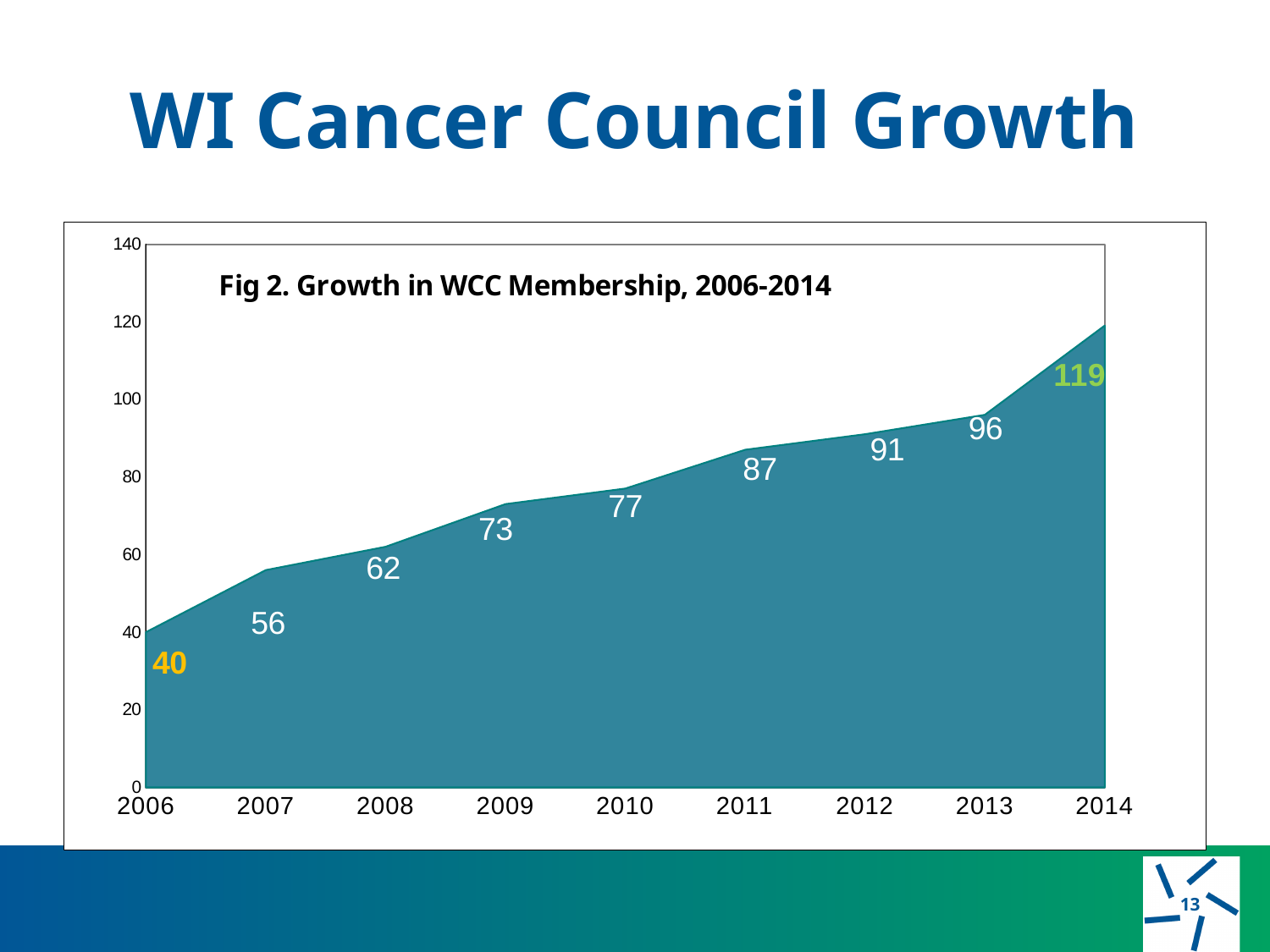
Is the membership value for 2012 greater or less than 100? less Which year has the lowest WCC membership? 2006 Which year had higher membership, 2009 or 2011? 2011 How many years are plotted on the x axis? 9 What was the WCC membership in 2006? 40 What was the WCC membership in 2010? 77 What was the WCC membership in 2014? 119 By how much did WCC membership grow from 2006 to 2014? 79 Does WCC membership rise or fall from 2006 to 2014? rise What kind of chart is shown on the slide? area chart Which year has the highest WCC membership? 2014 What is the difference in membership between 2013 and 2014? 23